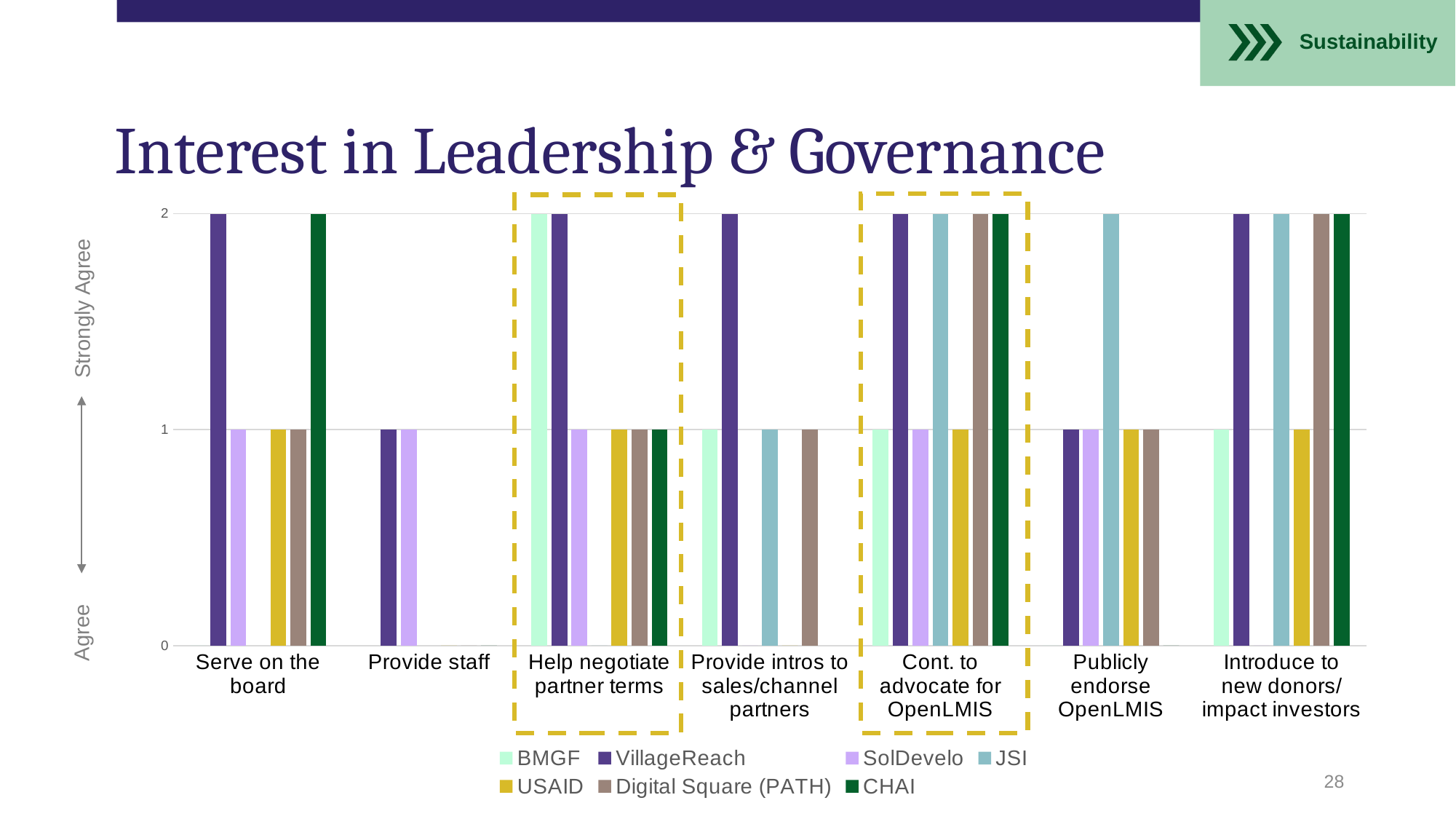
What kind of chart is shown on the slide? bar chart What is the value for JSI in the 'Publicly endorse OpenLMIS' category? 2 What is the value for CHAI in the 'Help negotiate partner terms' category? 1 Which is larger in the 'Serve on the board' category, the value for SolDevelo or the value for CHAI? CHAI Which two categories are outlined with dashed boxes? Help negotiate partner terms; Cont. to advocate for OpenLMIS What is the value for VillageReach in the 'Serve on the board' category? 2 What is the title of the chart? Interest in Leadership & Governance What is the value for BMGF in the 'Introduce to new donors/ impact investors' category? 1 What is the difference between the VillageReach value and the USAID value in the 'Help negotiate partner terms' category? 1 How many series does the legend list? 7 Which series has the highest value in the 'Provide intros to sales/channel partners' category? VillageReach How many categories are shown along the x axis? 7